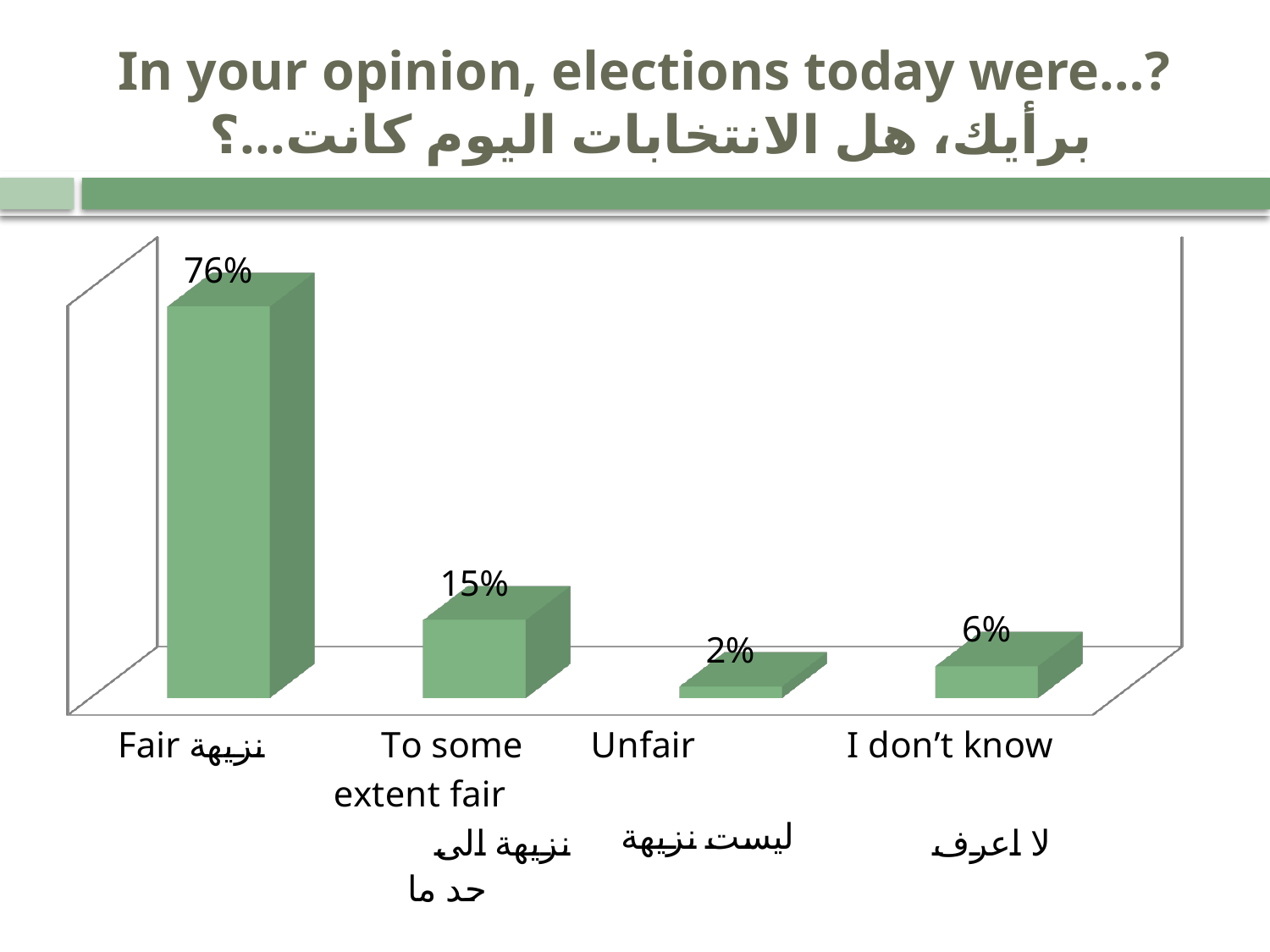
What is the value for 'I don't know'? 6% Which is larger, the value for 'I don't know' or the value for Unfair? I don't know How many categories are shown in the chart? 4 What percentage of respondents said the elections were Unfair? 2% What is the difference between the values for 'I don't know' and Unfair? 4% What is the value for 'To some extent fair'? 15% What kind of chart is shown on the slide? Bar chart What percentage of respondents said the elections were Fair? 76% What is the difference between the values for Fair and 'To some extent fair'? 61% Which category has the highest value? Fair What is the English title of the slide? In your opinion, elections today were...? Which category has the lowest value? Unfair